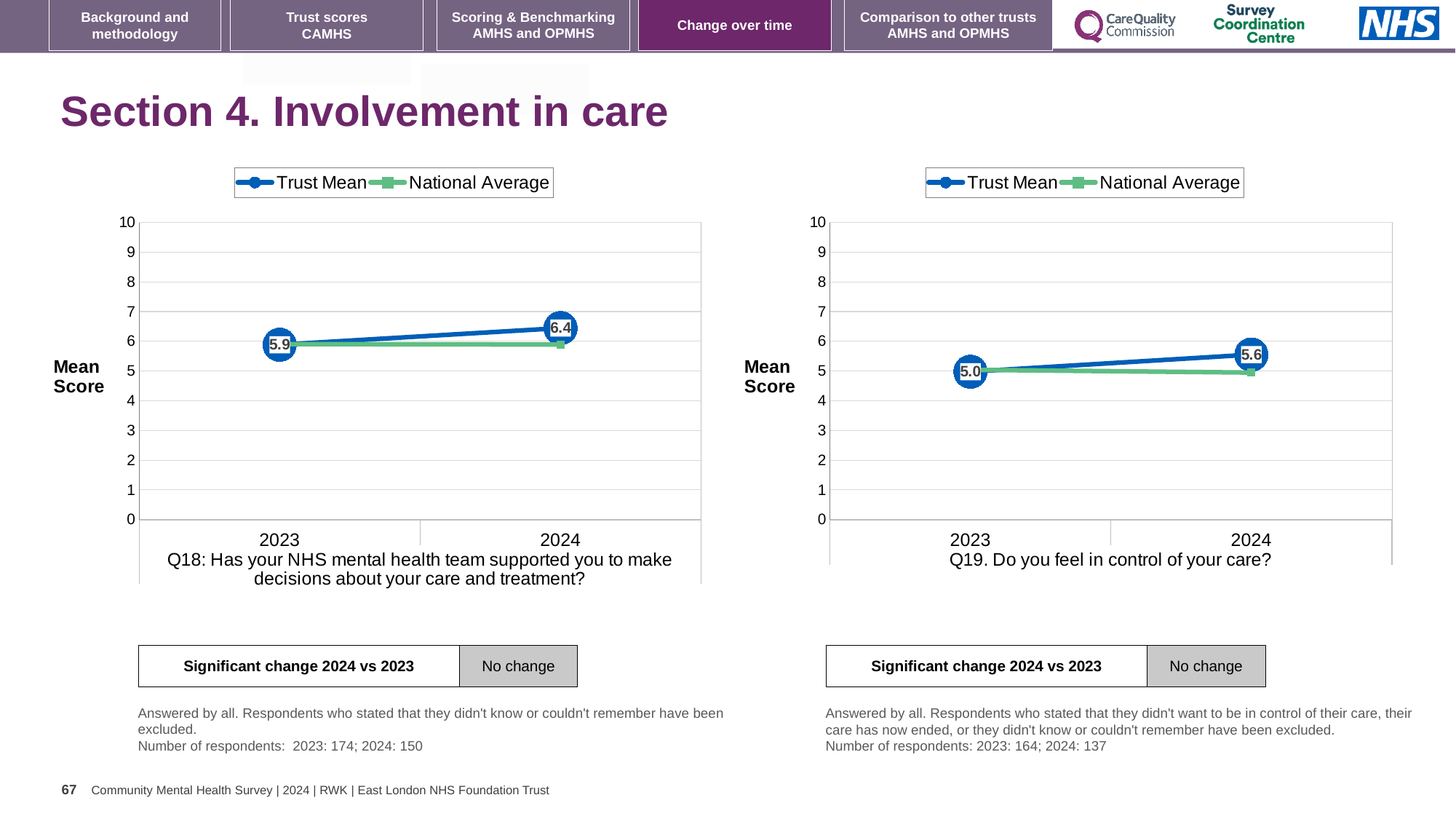
How many years are shown on the x axis of the left chart (Q18)? 2 On the right chart (Q19), by how much did the Trust Mean change from 2023 to 2024? 0.6 On the right chart (Q19), does the Trust Mean rise or fall from 2023 to 2024? rise On the right chart (Q19), what is the Trust Mean score for 2023? 5.0 On the left chart (Q18), which series has the higher value in 2024, Trust Mean or National Average? Trust Mean On the right chart (Q19), is the National Average value for 2024 greater or less than 6? less On the left chart (Q18), by how much did the Trust Mean change from 2023 to 2024? 0.5 How many series does the legend of the right chart (Q19) list? 2 On the right chart (Q19), what is the Trust Mean score for 2024? 5.6 On the left chart (Q18), what is the Trust Mean score for 2024? 6.4 On the left chart (Q18), what is the Trust Mean score for 2023? 5.9 What kind of chart is the left chart (Q18)? line chart